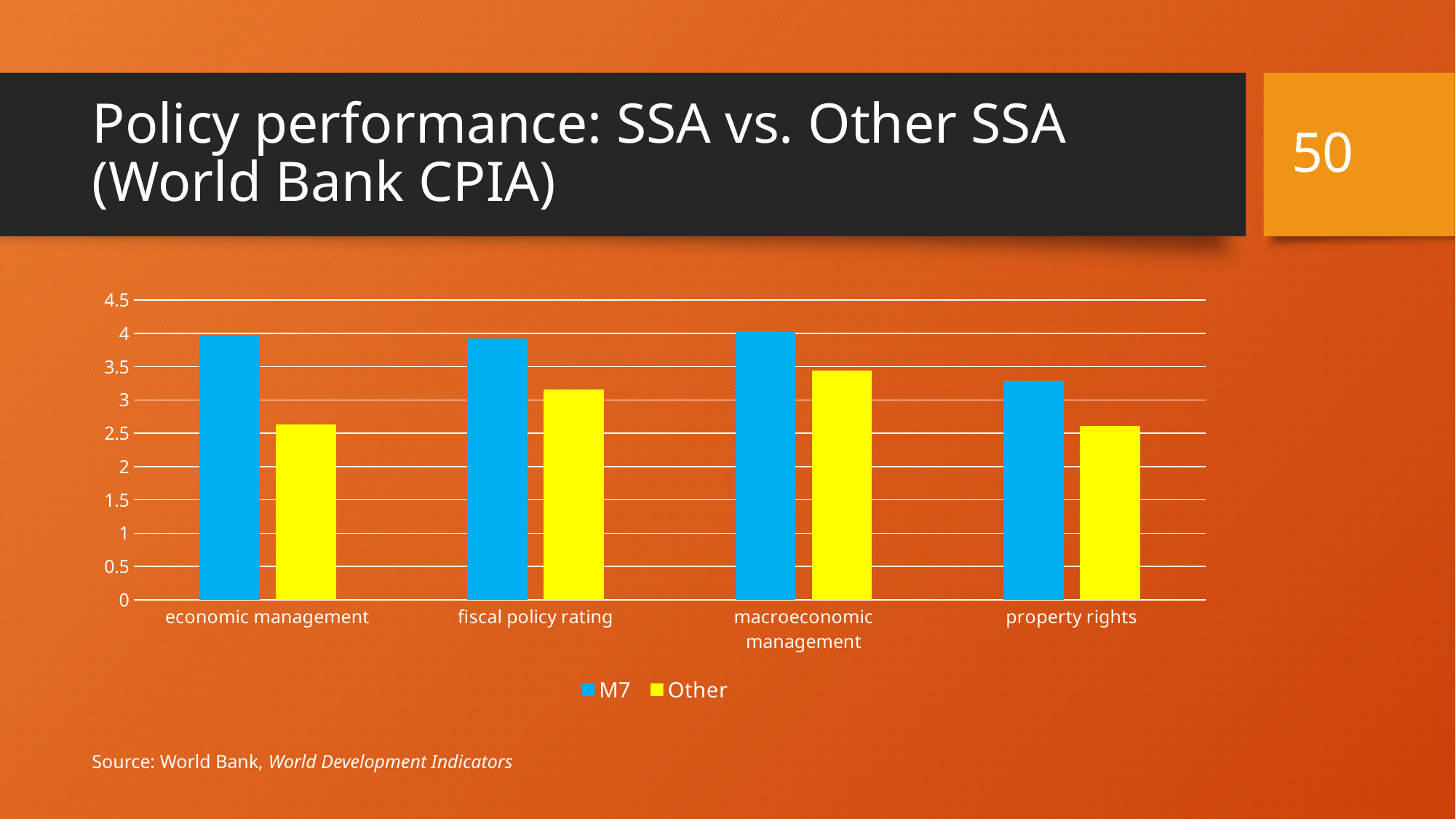
Is the Other value for economic management greater or less than 3? less Is the M7 value for economic management greater or less than 3.5? greater What kind of chart is shown on the slide? bar chart Which series has the higher value for property rights, M7 or Other? M7 For the M7 series, which category has the lowest value? property rights Is the Other value for fiscal policy rating greater or less than 3? greater Which series has the lower value for economic management, M7 or Other? Other How many series does the chart's legend list? 2 For the Other series, which category has the highest value? macroeconomic management How many categories are shown on the x axis of the chart? 4 What colour are the bars for the M7 series? blue